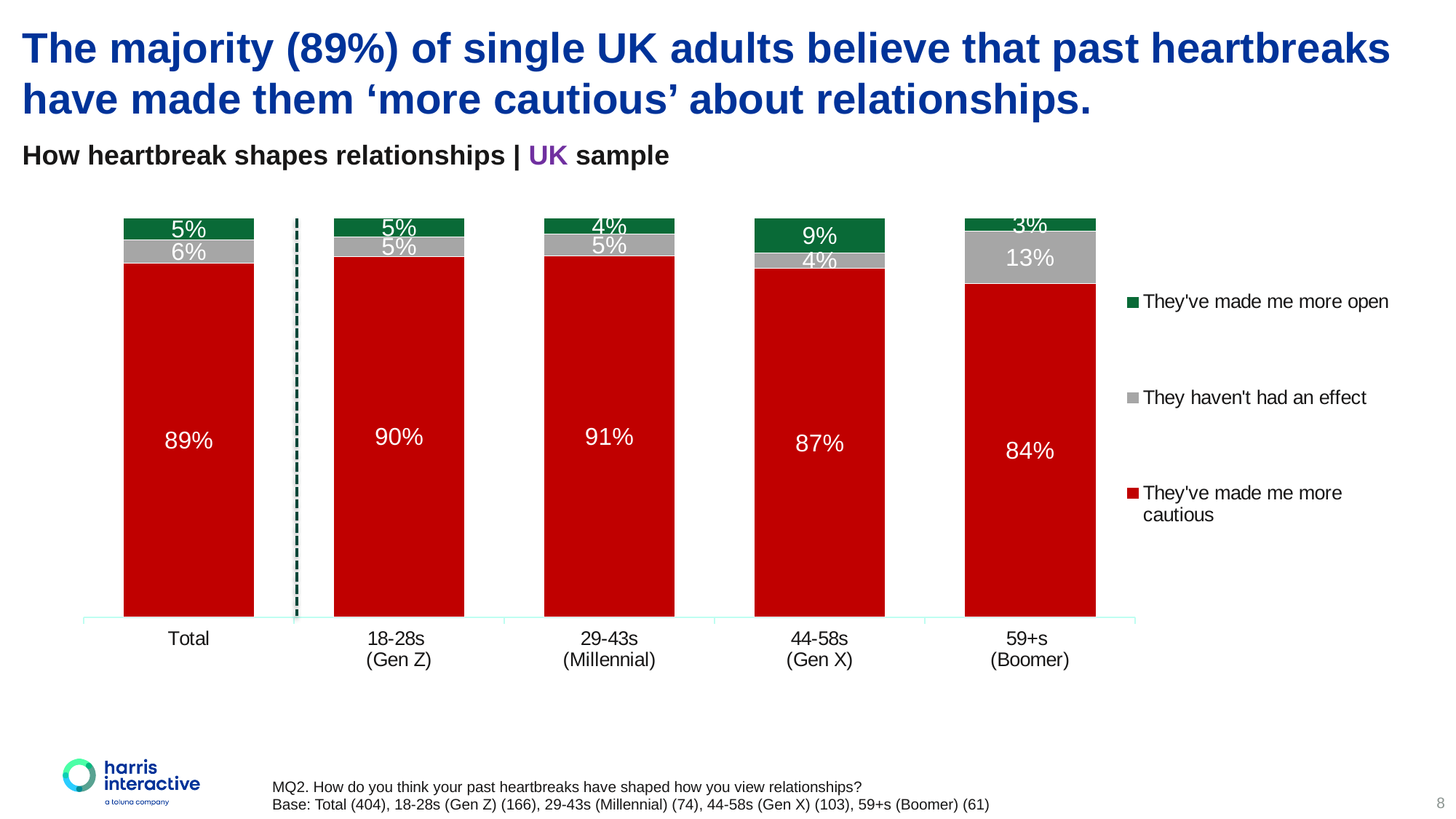
Which group has a larger 'They haven't had an effect' share: 59+s (Boomer) or 44-58s (Gen X)? 59+s (Boomer) What kind of chart is shown on the slide? Stacked bar chart What percentage of 59+s (Boomer) say heartbreaks haven't had an effect? 13% Which colour represents 'They've made me more cautious' in the chart? Red How many groups are shown on the x axis of the chart? 5 What is the total of the stacked bar for 44-58s (Gen X)? 100% How many series does the legend list? 3 Which age group has the highest share saying heartbreaks made them more cautious? 29-43s (Millennial) What percentage of 44-58s (Gen X) say heartbreaks have made them more open? 9% What percentage of the Total group say past heartbreaks have made them more cautious? 89% Which age group has the lowest share saying heartbreaks made them more cautious? 59+s (Boomer) What is the difference between the 'more cautious' share for 18-28s (Gen Z) and 59+s (Boomer)? 6 percentage points